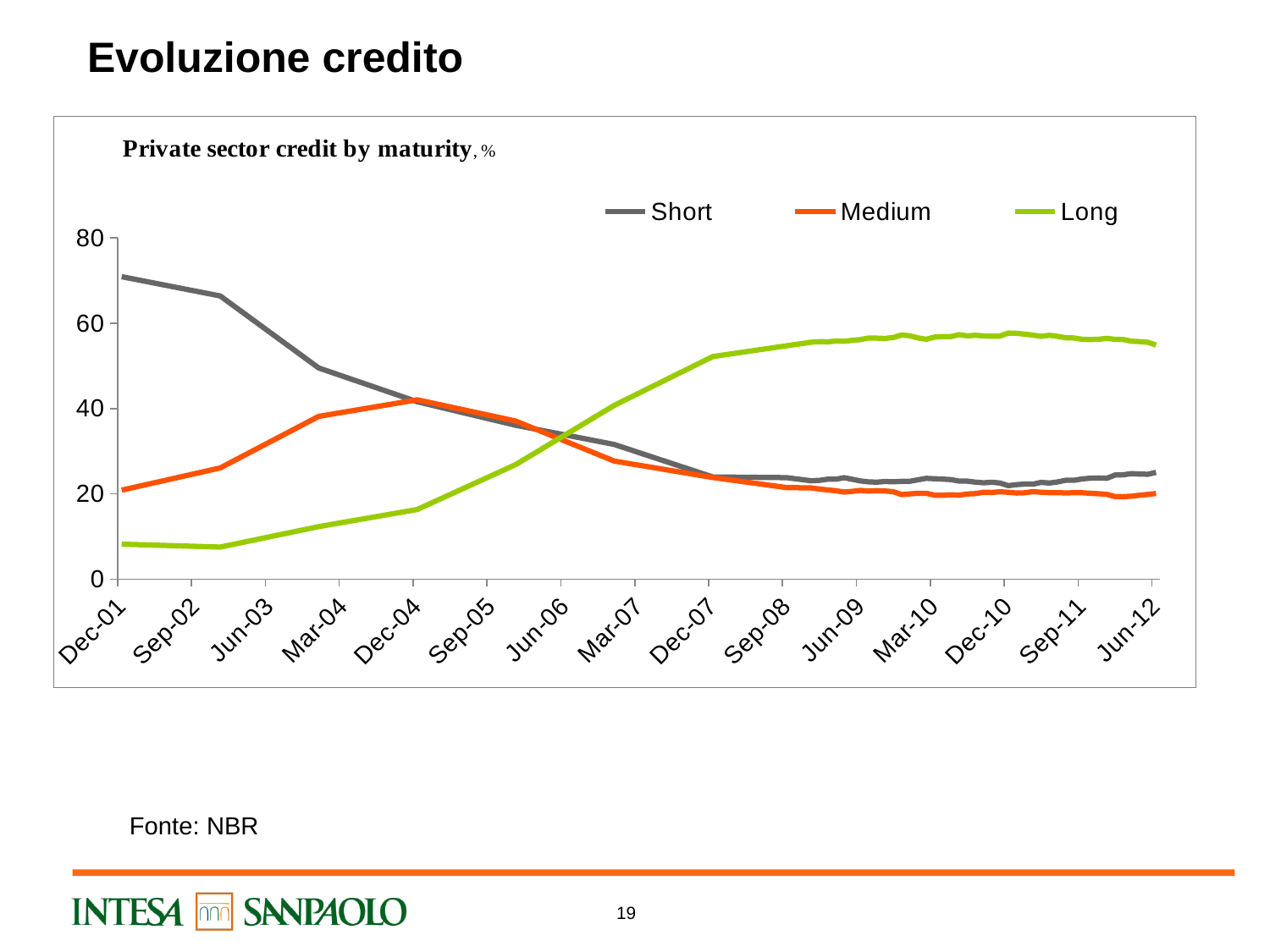
Is the value for Long at Jun-12 greater or less than 40? greater Is the value for Medium at Jun-12 greater or less than 40? less Which series has the highest value at Jun-12? Long Does the Short series rise or fall from Dec-01 to Dec-07? fall At Dec-01, which is larger: Short or Medium? Short What is the title of the chart? Private sector credit by maturity, % Which series has the lowest value at Dec-01? Long How many series does the legend list? 3 Is the value for Short at Dec-01 greater or less than 60? greater What kind of chart is shown on the slide? line chart What are the series names listed in the legend? Short, Medium, Long